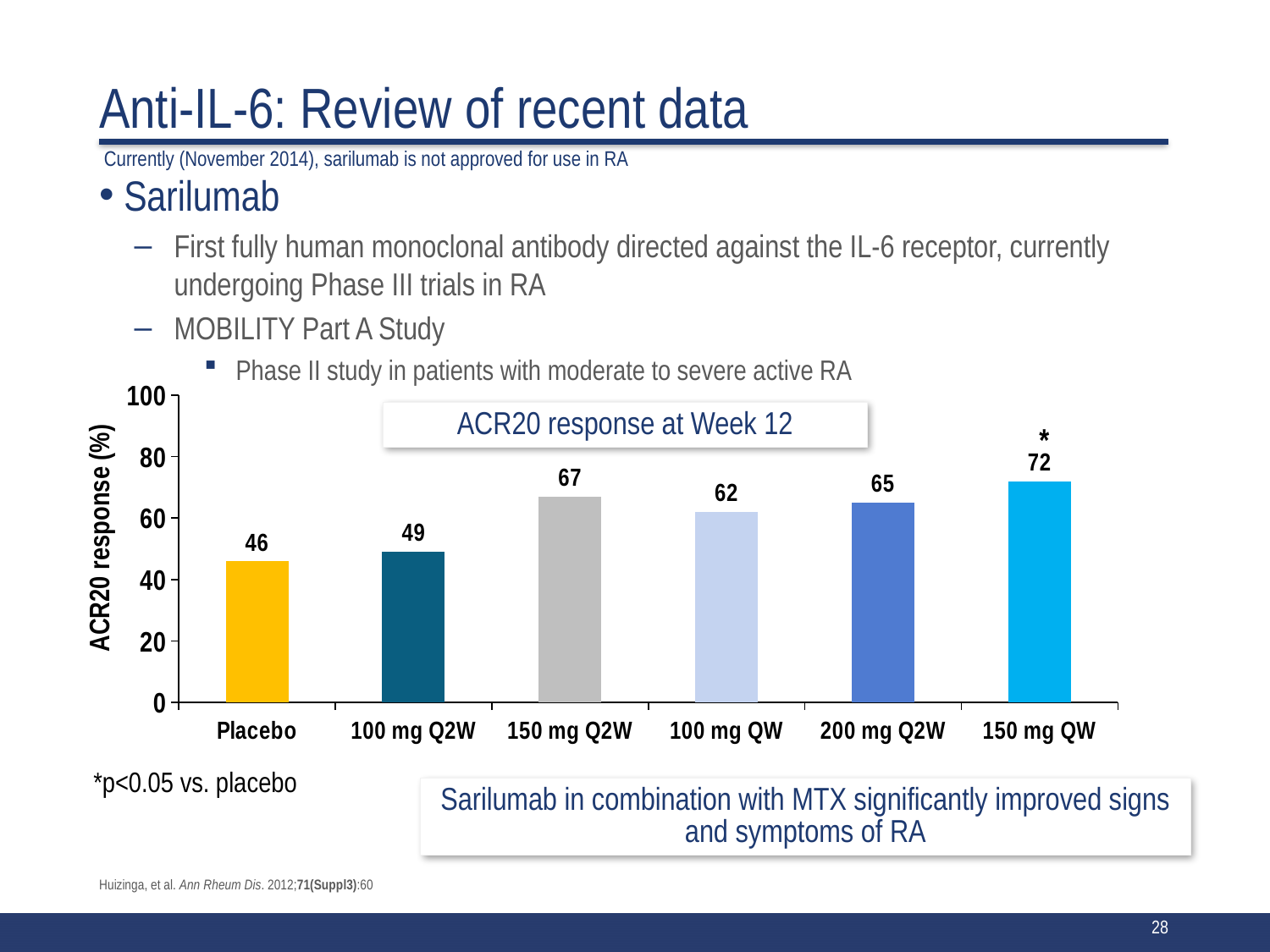
How many dose groups are shown on the x axis? 6 What is the ACR20 response for 150 mg QW? 72 Which dose group has the highest ACR20 response? 150 mg QW What is the ACR20 response for 100 mg QW? 62 Which group has the lowest ACR20 response? Placebo What is the difference in ACR20 response between 150 mg QW and Placebo? 26 What kind of chart is shown on the slide? bar chart What is the ACR20 response for Placebo? 46 Which has a higher ACR20 response, 150 mg Q2W or 200 mg Q2W? 150 mg Q2W Is the ACR20 response for 100 mg Q2W greater or less than 60? less What is the difference in ACR20 response between 150 mg Q2W and 100 mg Q2W? 18 What is the title shown in the box above the chart? ACR20 response at Week 12